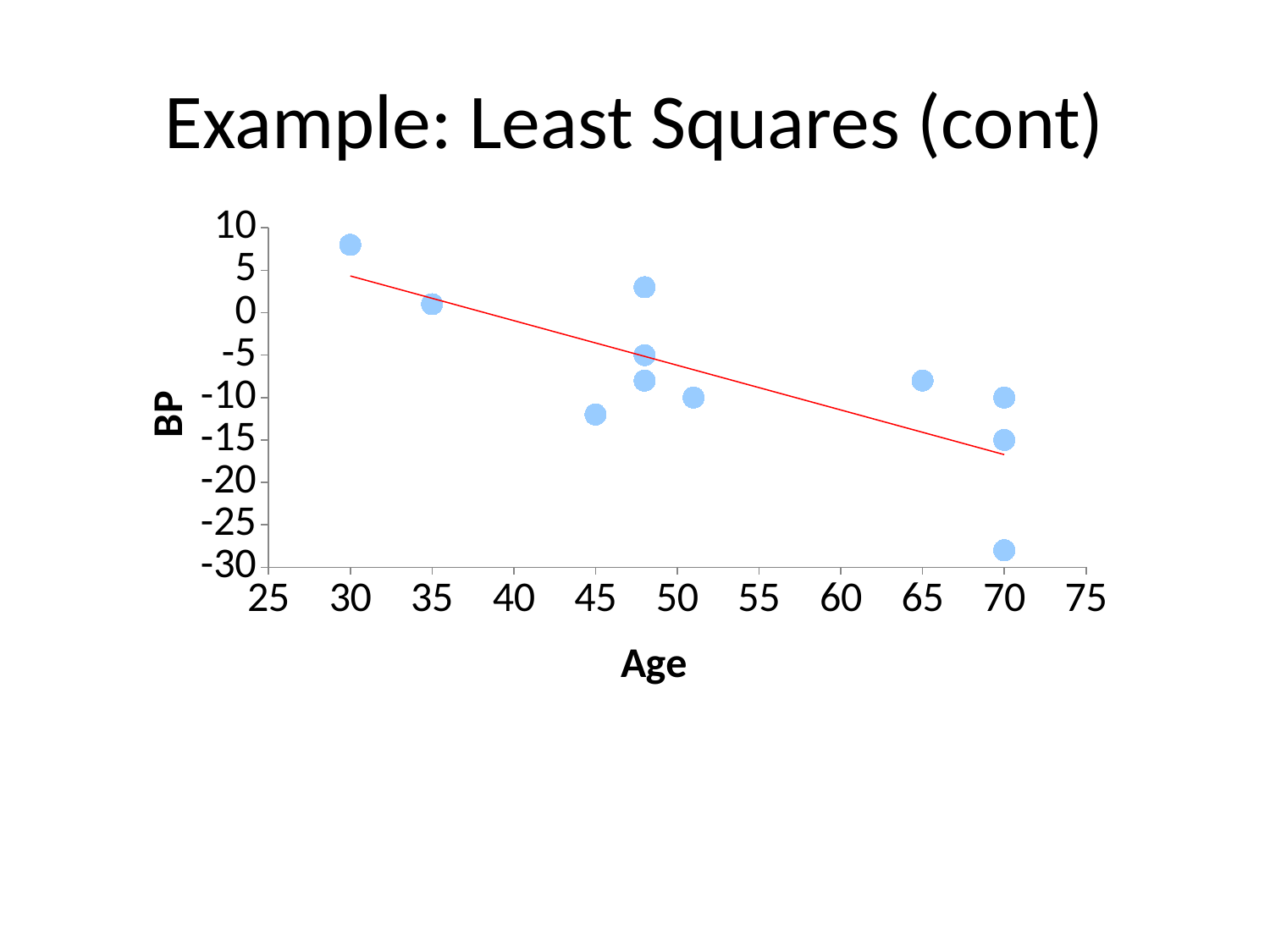
What kind of chart is shown on the slide? scatter plot Is the BP value for Age 65 greater or less than -15? greater Which has the higher BP value: the point at Age 30 or the point at Age 65? Age 30 How many data points are plotted on the chart? 11 What is the label of the y axis? BP At which Age is the highest BP value plotted? 30 What is the label of the x axis? Age At which Age is the lowest BP value plotted? 70 Is the BP value for Age 45 greater or less than -5? less Do the BP values generally rise or fall as Age increases? fall Is the lowest BP value at Age 70 greater or less than -25? less